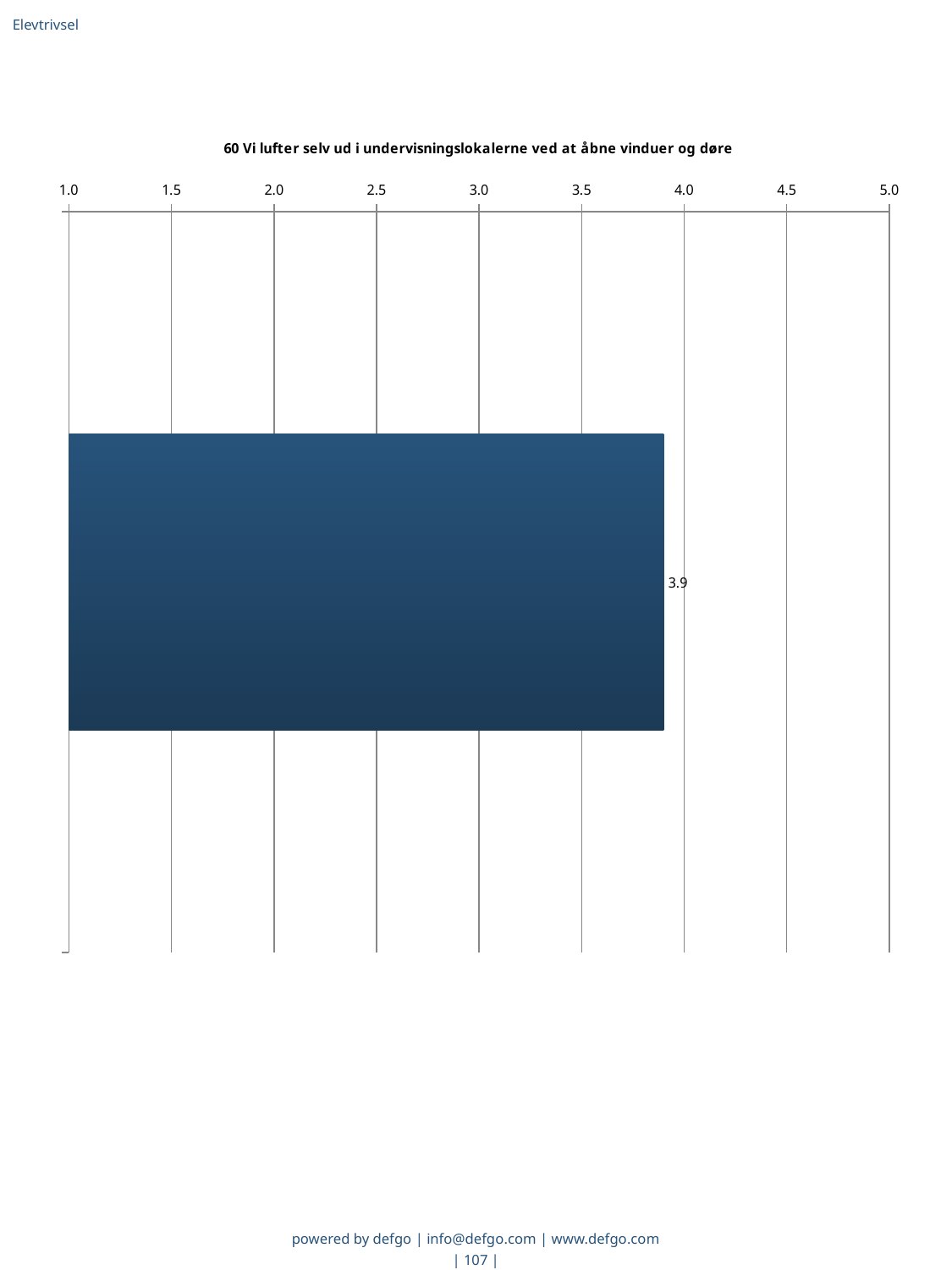
What is the title of the chart? 60 Vi lufter selv ud i undervisningslokalerne ved at åbne vinduer og døre What is the lowest value shown on the chart's axis? 1.0 Is the value of the bar greater or less than 4.0? less How many bars are plotted in the chart? 1 What value is shown by the bar in the chart? 3.9 What is the highest value shown on the chart's axis? 5.0 Is the value of the bar greater or less than 3.0? greater Is the value of the bar greater or less than 3.5? greater What kind of chart is shown on the slide? bar chart